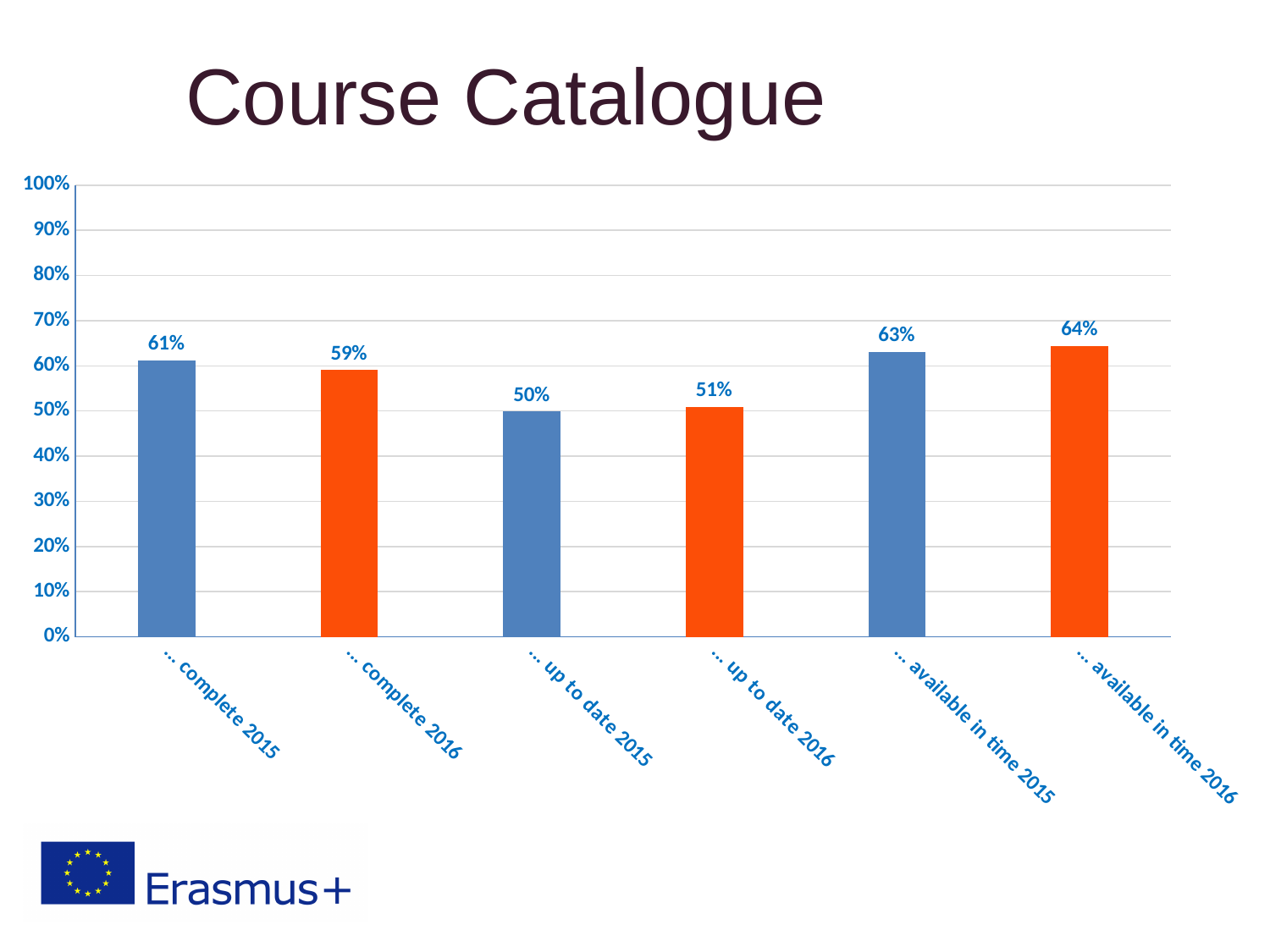
Which is larger, '... up to date 2015' or '... up to date 2016'? ... up to date 2016 How many bars are shown in the chart? 6 What kind of chart is shown on the slide? bar chart What is the value for '... up to date 2016'? 51% What is the value for '... available in time 2015'? 63% What is the title of the slide? Course Catalogue Which category has the highest value? ... available in time 2016 What is the difference between '... available in time 2016' and '... up to date 2016'? 13% Is the value for '... complete 2016' greater or less than 50%? greater What is the difference between '... complete 2015' and '... complete 2016'? 2% What is the value for '... complete 2015'? 61% Which category has the lowest value? ... up to date 2015